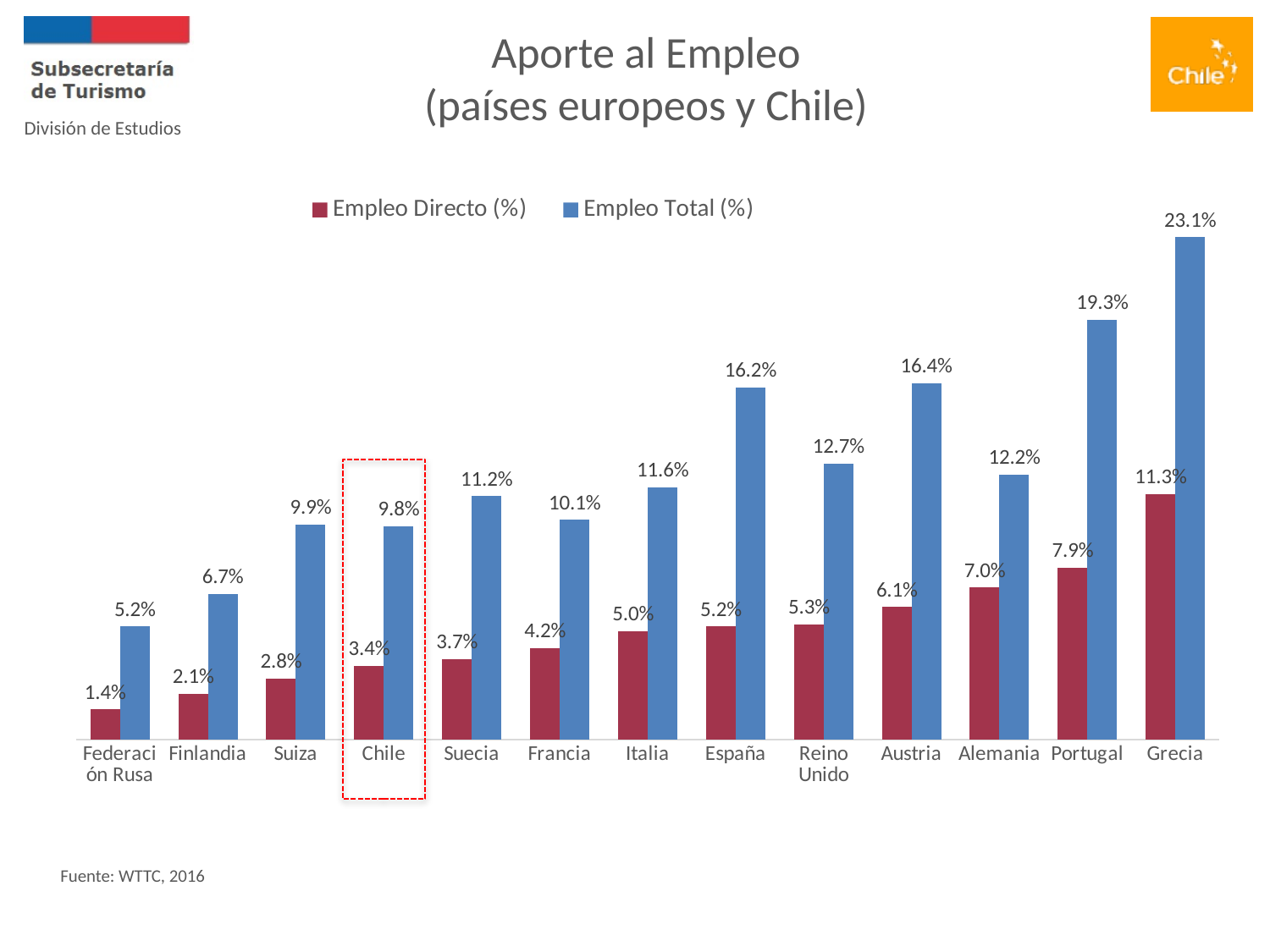
What kind of chart is shown on the slide? Bar chart What is the Empleo Directo (%) value for Portugal? 7.9% Do the Empleo Total (%) values generally rise or fall from Federación Rusa to Grecia? Rise What is the Empleo Directo (%) value for Reino Unido? 5.3% Which is larger, the Empleo Total (%) for Austria or for España? Austria Which country has the highest Empleo Total (%)? Grecia What is the Empleo Total (%) value for Chile? 9.8% What is the difference between Empleo Total (%) and Empleo Directo (%) for Grecia? 11.8% How many series does the legend list? 2 Which country is highlighted with a dashed red box on the chart? Chile How many countries are shown on the x axis? 13 Which country has the lowest Empleo Directo (%)? Federación Rusa